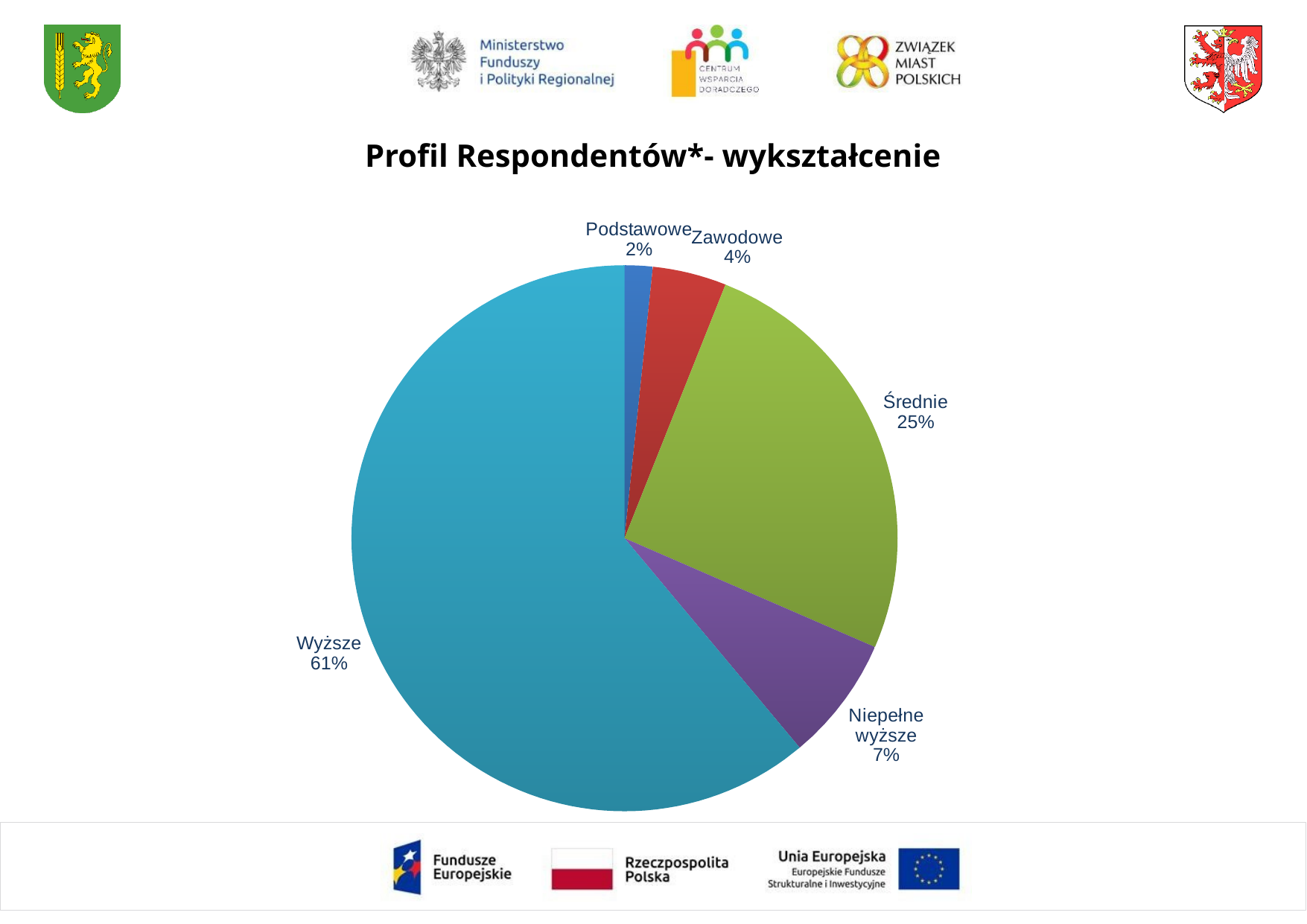
Which education category has the smallest share? Podstawowe What type of chart is shown on the slide? Pie chart Which education category has the largest share? Wyższe What percentage of respondents have Średnie education? 25% What share of respondents have Wyższe education? 61% What share is shown for Podstawowe? 2% What is the difference in percentage points between Wyższe and Średnie? 36 What percentage is shown for Zawodowe? 4% How many categories are shown in the pie chart? 5 What share is shown for Niepełne wyższe? 7% What is the title of the chart? Profil Respondentów*- wykształcenie Which is larger, the share for Niepełne wyższe or the share for Zawodowe? Niepełne wyższe